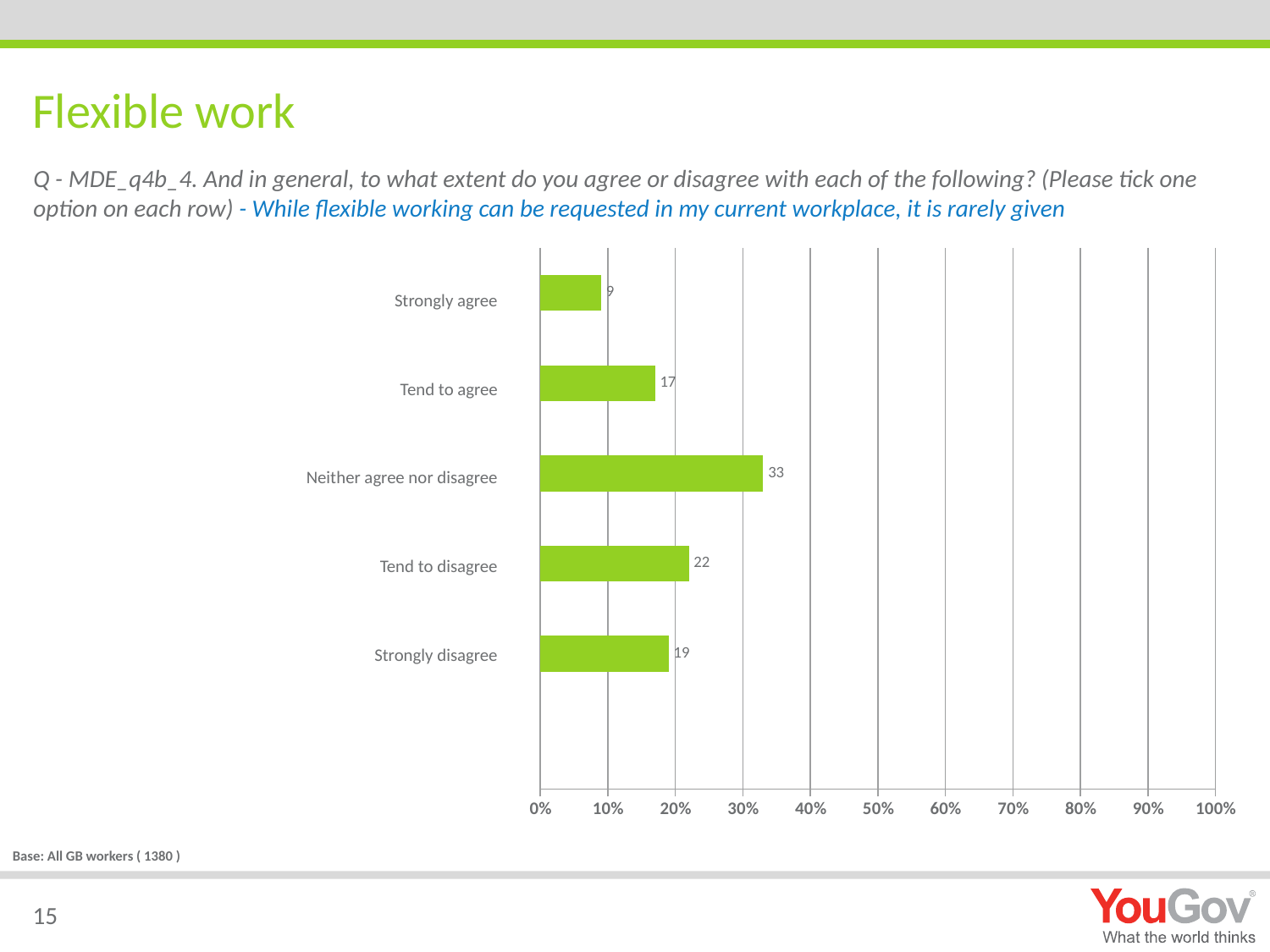
Which category has the highest value? Neither agree nor disagree Is the value for Neither agree nor disagree greater or less than 30%? greater Which is larger, the value for Strongly disagree or the value for Tend to agree? Strongly disagree What kind of chart is shown on the slide? Bar chart What colour are the bars in the chart? Green What is the value for Neither agree nor disagree? 33 How many categories are shown in the chart? 5 What is the difference between the values for Tend to disagree and Tend to agree? 5 What is the value for Tend to disagree? 22 What is the value for Strongly agree? 9 Which category has the lowest value? Strongly agree What is the highest value shown on the x axis? 100%